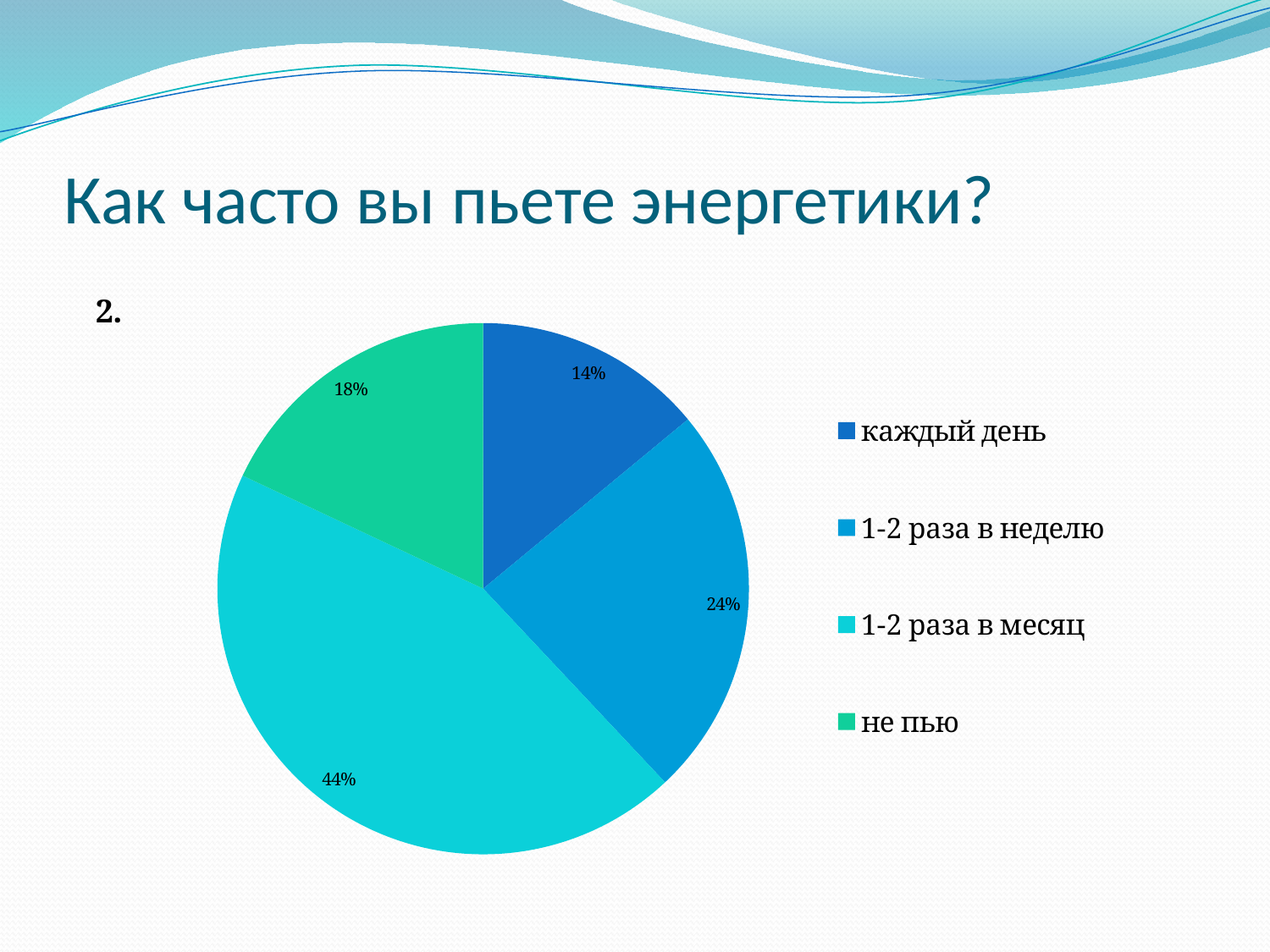
How many slices does the pie chart have? 4 Which category has the smallest slice of the pie? каждый день What share of the pie is labelled "1-2 раза в неделю"? 24% Which legend entry is shown in green? не пью What share of the pie is labelled "каждый день"? 14% What kind of chart is shown on the slide? pie chart What share of the pie is labelled "не пью"? 18% What is the title of the slide containing the chart? Как часто вы пьете энергетики? Which is larger: the slice for "не пью" or the slice for "каждый день"? не пью What share of the pie is labelled "1-2 раза в месяц"? 44% What is the difference in percentage points between "1-2 раза в месяц" and "1-2 раза в неделю"? 20 Which category has the largest slice of the pie? 1-2 раза в месяц